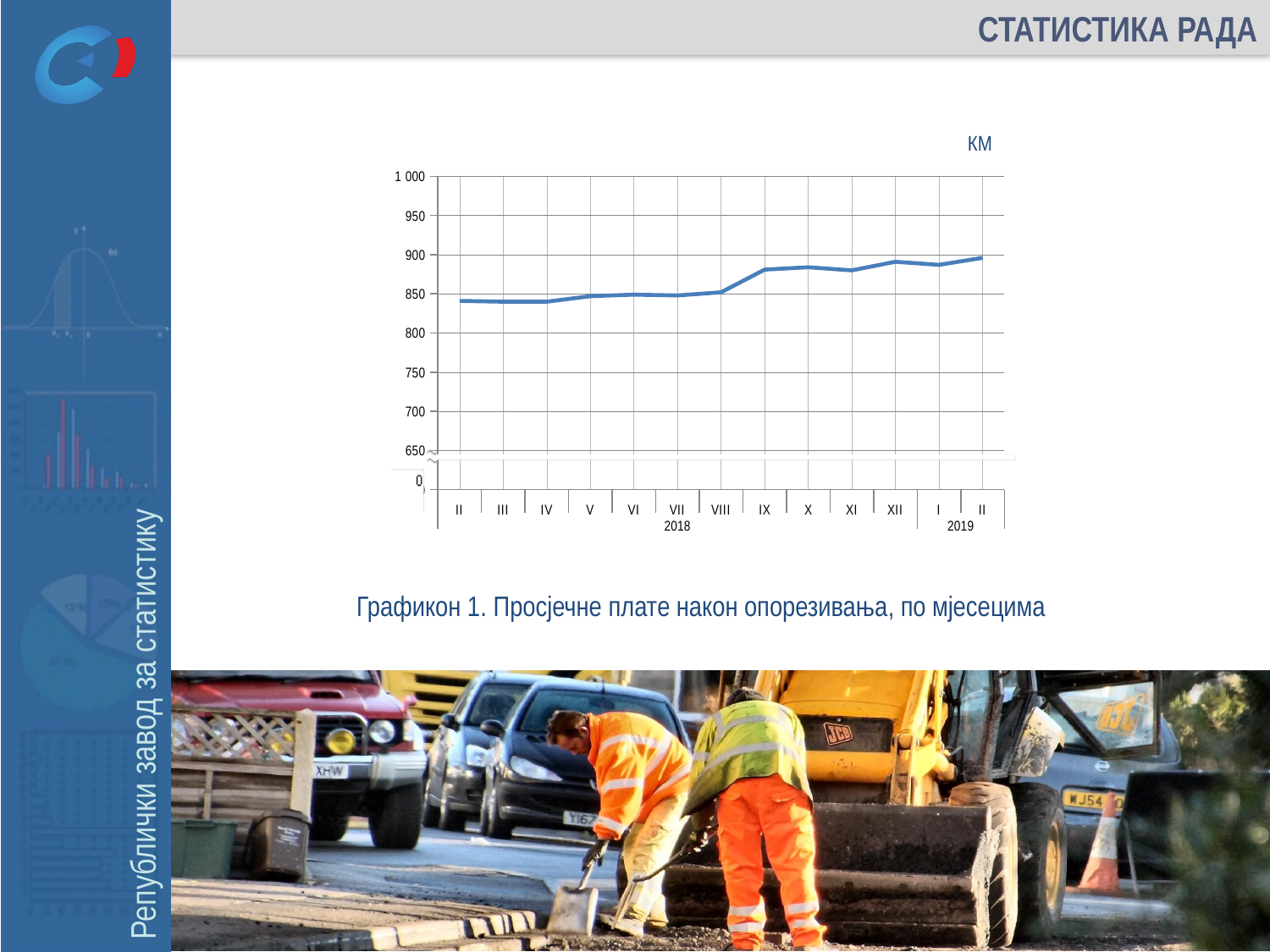
Which is larger, the value for IX 2018 or the value for VIII 2018? IX 2018 What kind of chart is shown on the slide? line chart Which is larger, the value for II 2018 or the value for II 2019? II 2019 How many monthly data points are plotted on the chart? 13 Is the value for XII 2018 greater or less than 850? greater What is the title of the chart on the slide? Графикон 1. Просјечне плате након опорезивања, по мјесецима What unit is indicated above the chart's vertical axis? КМ Which month has the highest value on the chart? II 2019 Is the value for IX 2018 greater or less than 850? greater Do the values generally rise or fall from II 2018 to II 2019? rise Is the value for II 2018 greater or less than 850? less